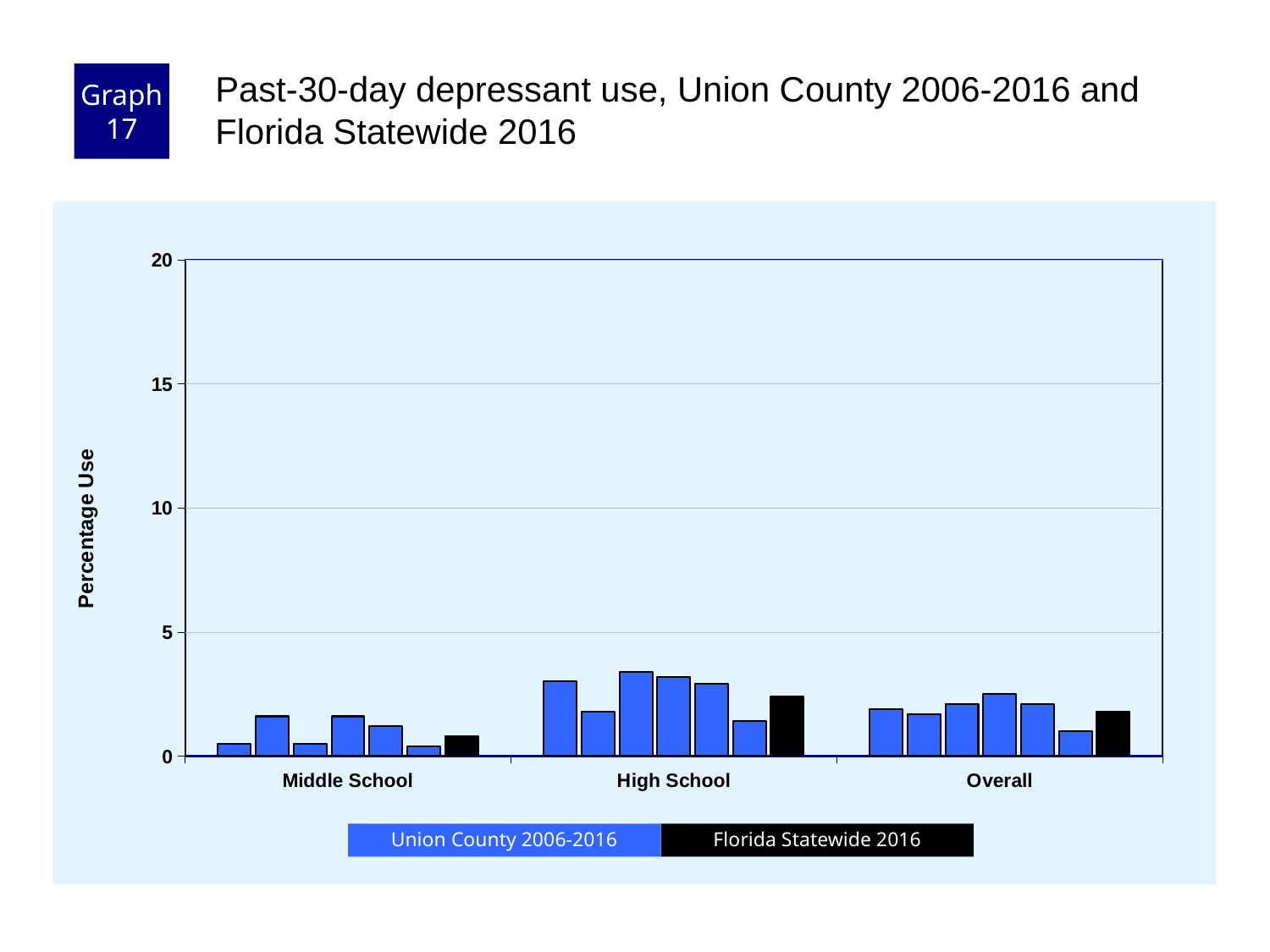
Are any of the bars on the chart greater than 10? No Which colour represents Florida Statewide 2016 in the legend? Black Is the Florida Statewide 2016 value for Middle School greater or less than 5? less What kind of chart is shown on the slide? Bar chart How many categories are shown along the x axis? 3 For Florida Statewide 2016, which category has the lowest value? Middle School Which is larger: the Florida Statewide 2016 value for Overall or for Middle School? Overall For Florida Statewide 2016, which category has the highest value? High School How many series does the legend list? 2 Is the Florida Statewide 2016 value for High School greater or less than 5? less What is the label on the y axis? Percentage Use Which is larger: the Florida Statewide 2016 value for High School or for Middle School? High School